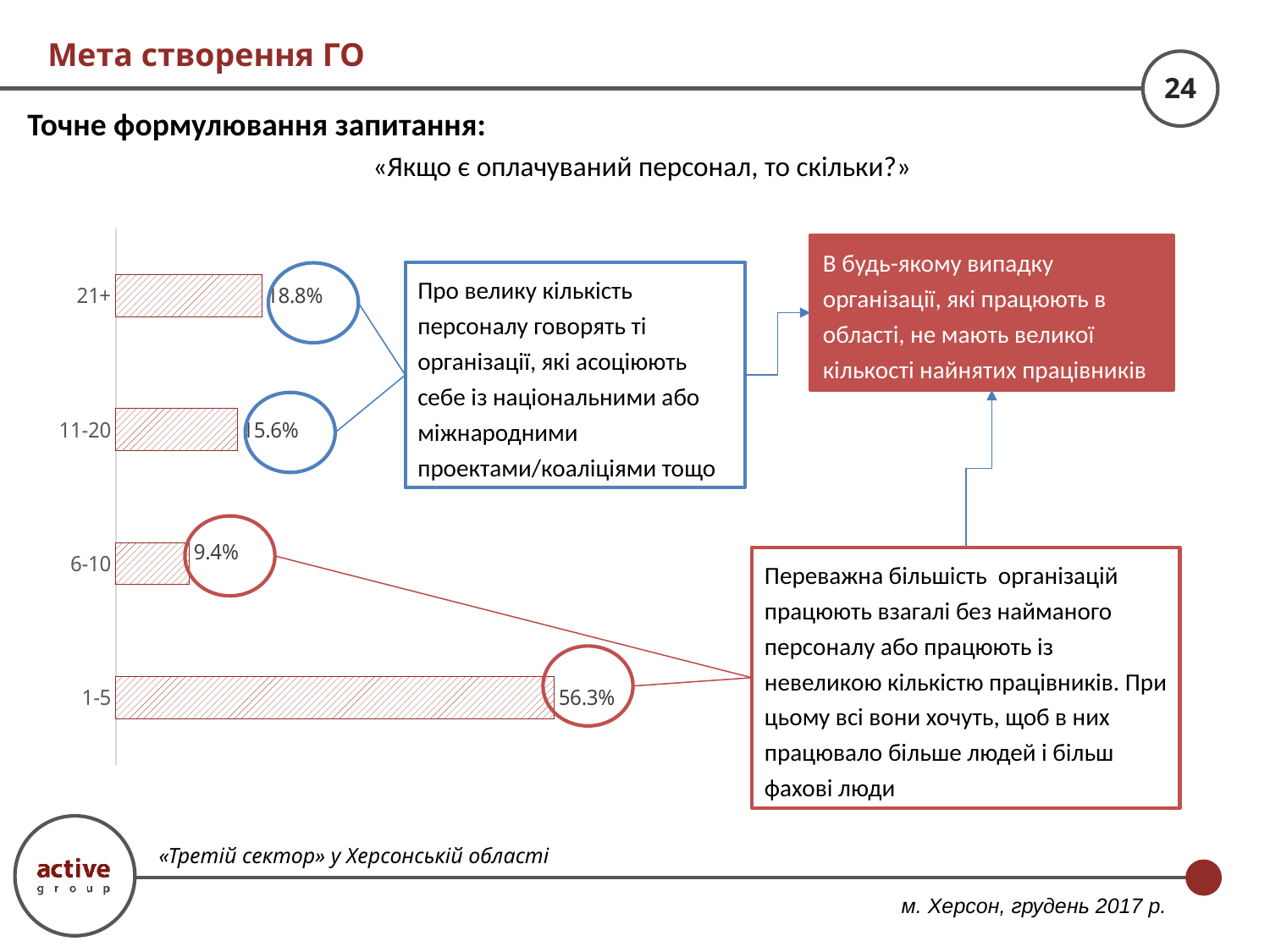
What kind of chart is shown on the slide? bar chart Which category has the lowest value? 6-10 Which category has the highest value? 1-5 What is the difference between the values for 1-5 and 21+? 37.5% Which is larger, the value for 21+ or the value for 6-10? 21+ What is the value for the 1-5 category? 56.3% What is the value for the 21+ category? 18.8% What is the difference between the values for 21+ and 11-20? 3.2% What question is the chart answering, as stated above it? «Якщо є оплачуваний персонал, то скільки?» What is the value for the 11-20 category? 15.6% What is the value for the 6-10 category? 9.4% How many categories are shown in the chart? 4